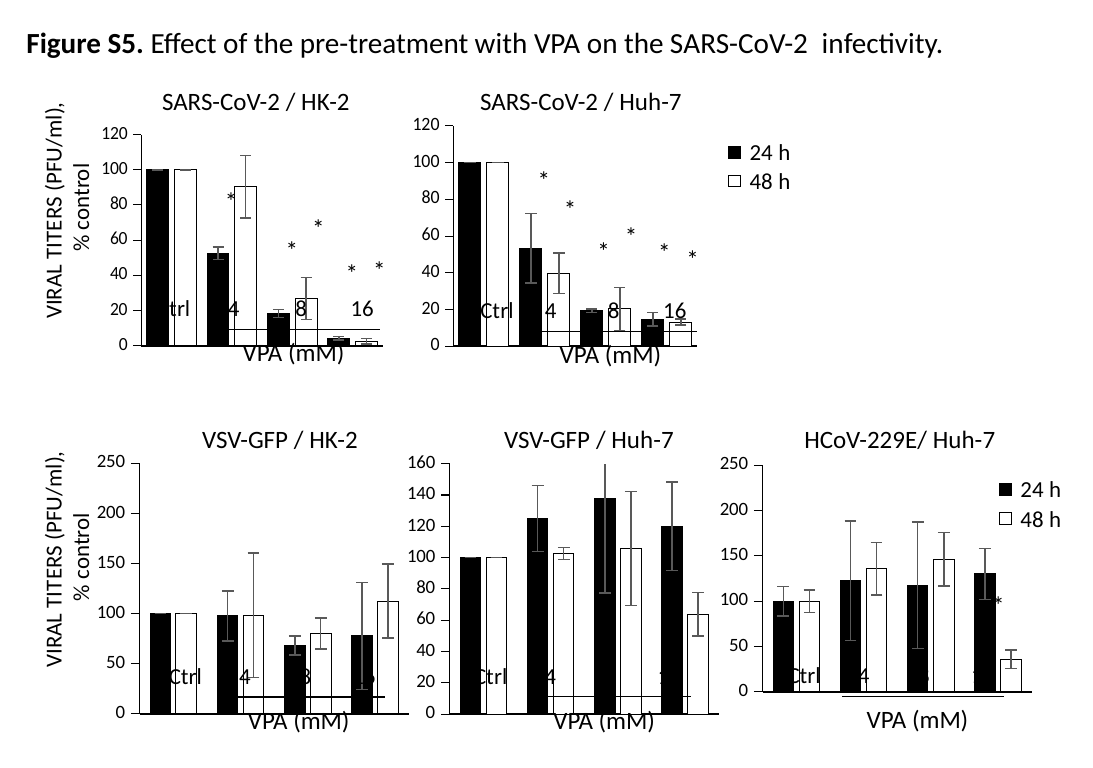
In the SARS-CoV-2 / HK-2 chart at 4 mM VPA, which series has the larger value, 24 h or 48 h? 48 h In the SARS-CoV-2 / HK-2 chart, what is the value for Ctrl in the 24 h series? 100 How many series does the legend list for the SARS-CoV-2 / HK-2 chart? 2 In the SARS-CoV-2 / HK-2 chart, is the 24 h value at 16 mM VPA greater or less than 20? less How many VPA concentration categories (including Ctrl) are shown in the SARS-CoV-2 / HK-2 chart? 4 In the SARS-CoV-2 / HK-2 chart, do the 24 h values rise or fall as the VPA concentration increases? fall In the VSV-GFP / Huh-7 chart, is the 24 h value at 8 mM VPA greater or less than 120? greater In the SARS-CoV-2 / HK-2 chart, which category has the lowest 24 h value? 16 In the HCoV-229E/ Huh-7 chart, is the 48 h value at 16 mM VPA greater or less than 50? less What kind of chart is the SARS-CoV-2 / Huh-7 chart? bar chart